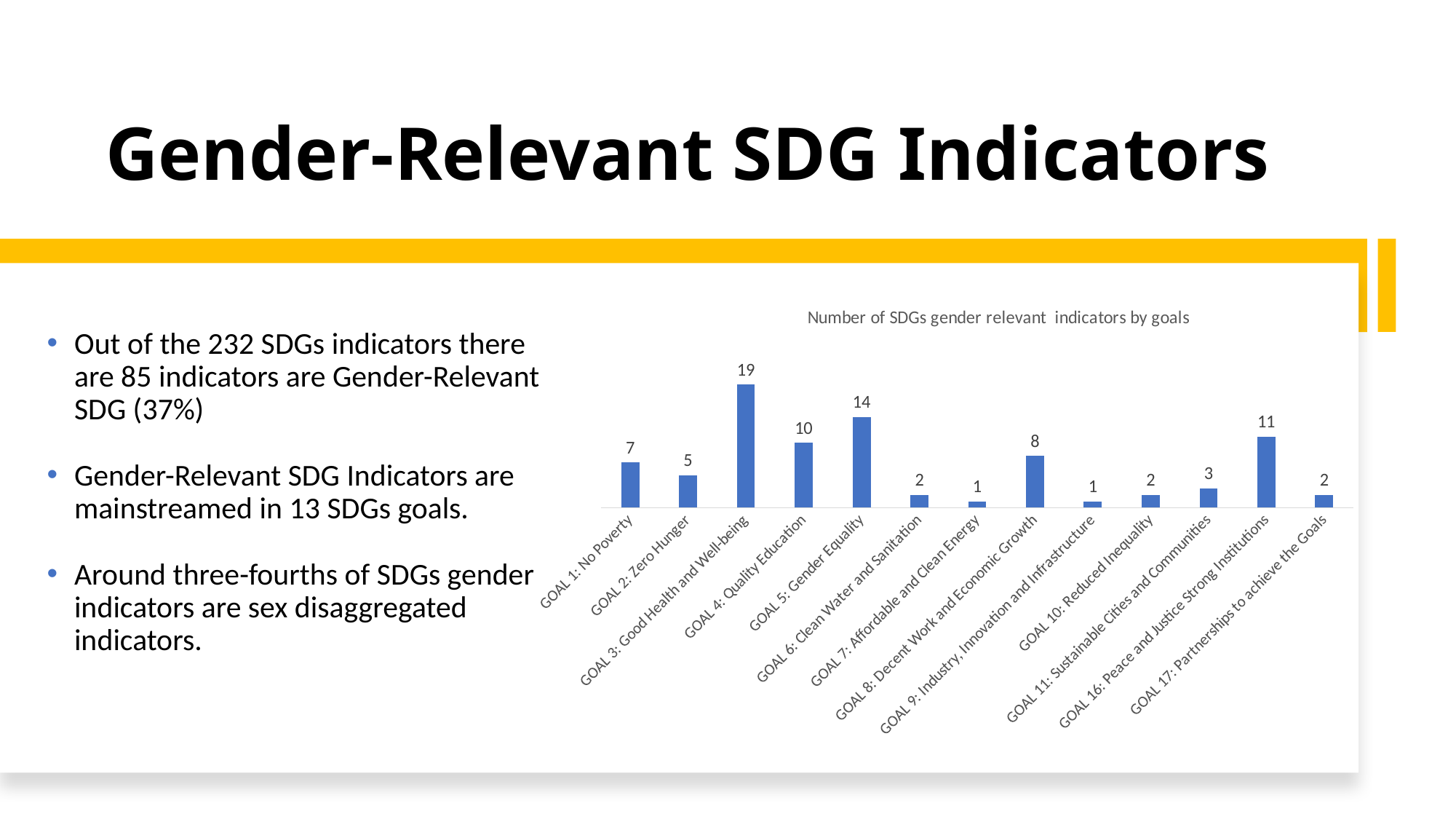
What is the title of the chart? Number of SDGs gender relevant indicators by goals What is the value for GOAL 3: Good Health and Well-being? 19 What is the value for GOAL 5: Gender Equality? 14 What is the difference between the values for GOAL 3: Good Health and Well-being and GOAL 5: Gender Equality? 5 What is the difference between the values for GOAL 1: No Poverty and GOAL 2: Zero Hunger? 2 How many goals (categories) are shown in the chart? 13 Which goal has the highest number of gender relevant indicators? GOAL 3: Good Health and Well-being What is the value for GOAL 16: Peace and Justice Strong Institutions? 11 What is the value for GOAL 10: Reduced Inequality? 2 What is the value for GOAL 8: Decent Work and Economic Growth? 8 What kind of chart is shown on the slide? Bar chart Which is larger, the value for GOAL 4: Quality Education or the value for GOAL 16: Peace and Justice Strong Institutions? GOAL 16: Peace and Justice Strong Institutions